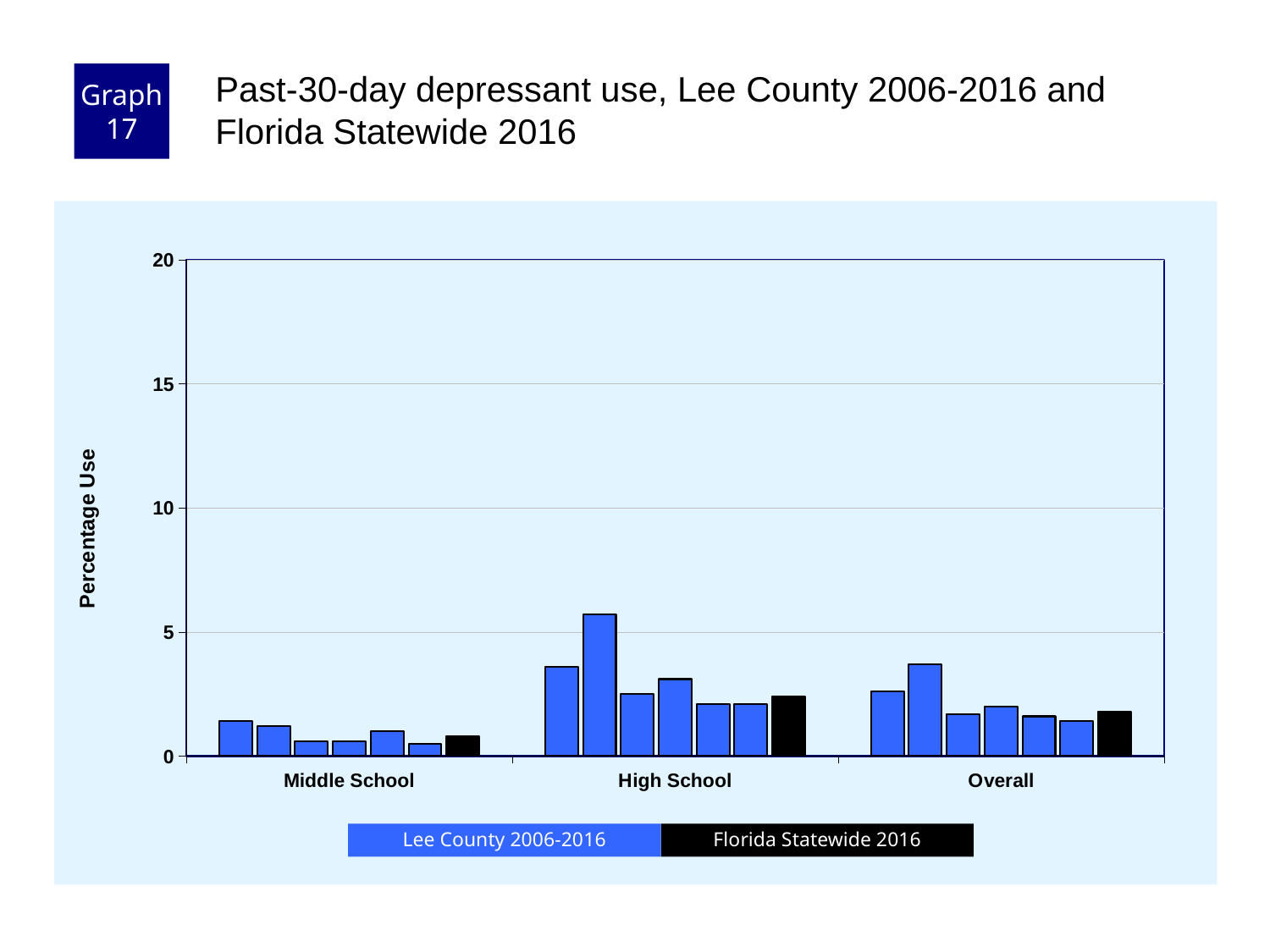
Is the tallest bar in the High School group greater or less than 5? greater Is the Florida Statewide 2016 value for Middle School greater or less than 5? less Which is larger, the Florida Statewide 2016 value for High School or for Middle School? High School What kind of chart is shown on the slide? bar chart How many bars are plotted in the Overall category? 7 Is the Florida Statewide 2016 value for Overall greater or less than 5? less Which colour represents Florida Statewide 2016 in the legend? black Which category contains the tallest bar on the chart? High School Which category has the lowest Florida Statewide 2016 value? Middle School How many series does the legend list? 2 What is the label of the y axis? Percentage Use How many categories are shown on the x axis? 3